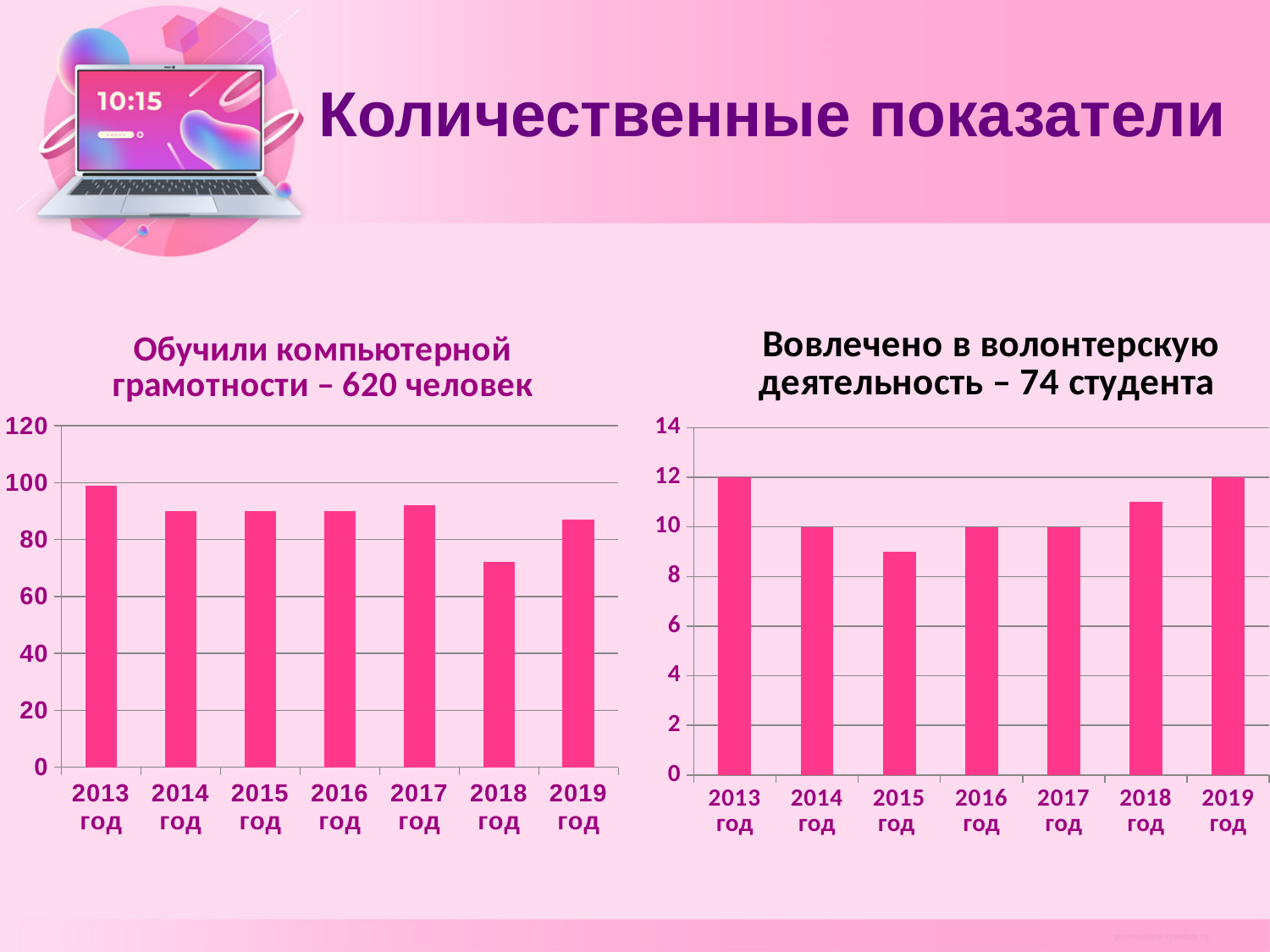
In the right chart "Вовлечено в волонтерскую деятельность", what is the value for 2013 год? 12 In the right chart "Вовлечено в волонтерскую деятельность", what is the difference between the values for 2013 год and 2014 год? 2 In the left chart "Обучили компьютерной грамотности", which is larger, the value for 2013 год or 2018 год? 2013 год In the left chart "Обучили компьютерной грамотности", is the value for 2018 год greater or less than 80? less In the left chart "Обучили компьютерной грамотности", which year has the lowest value? 2018 год In the right chart "Вовлечено в волонтерскую деятельность", do the values rise or fall from 2017 год to 2019 год? rise How many years are shown on the x axis of the right chart "Вовлечено в волонтерскую деятельность – 74 студента"? 7 In the right chart "Вовлечено в волонтерскую деятельность", what is the value for 2014 год? 10 What kind of chart is the left chart titled "Обучили компьютерной грамотности – 620 человек"? bar chart In the right chart "Вовлечено в волонтерскую деятельность", what is the value for 2019 год? 12 In the right chart "Вовлечено в волонтерскую деятельность", which year has the lowest value? 2015 год In the left chart "Обучили компьютерной грамотности", which year has the highest value? 2013 год